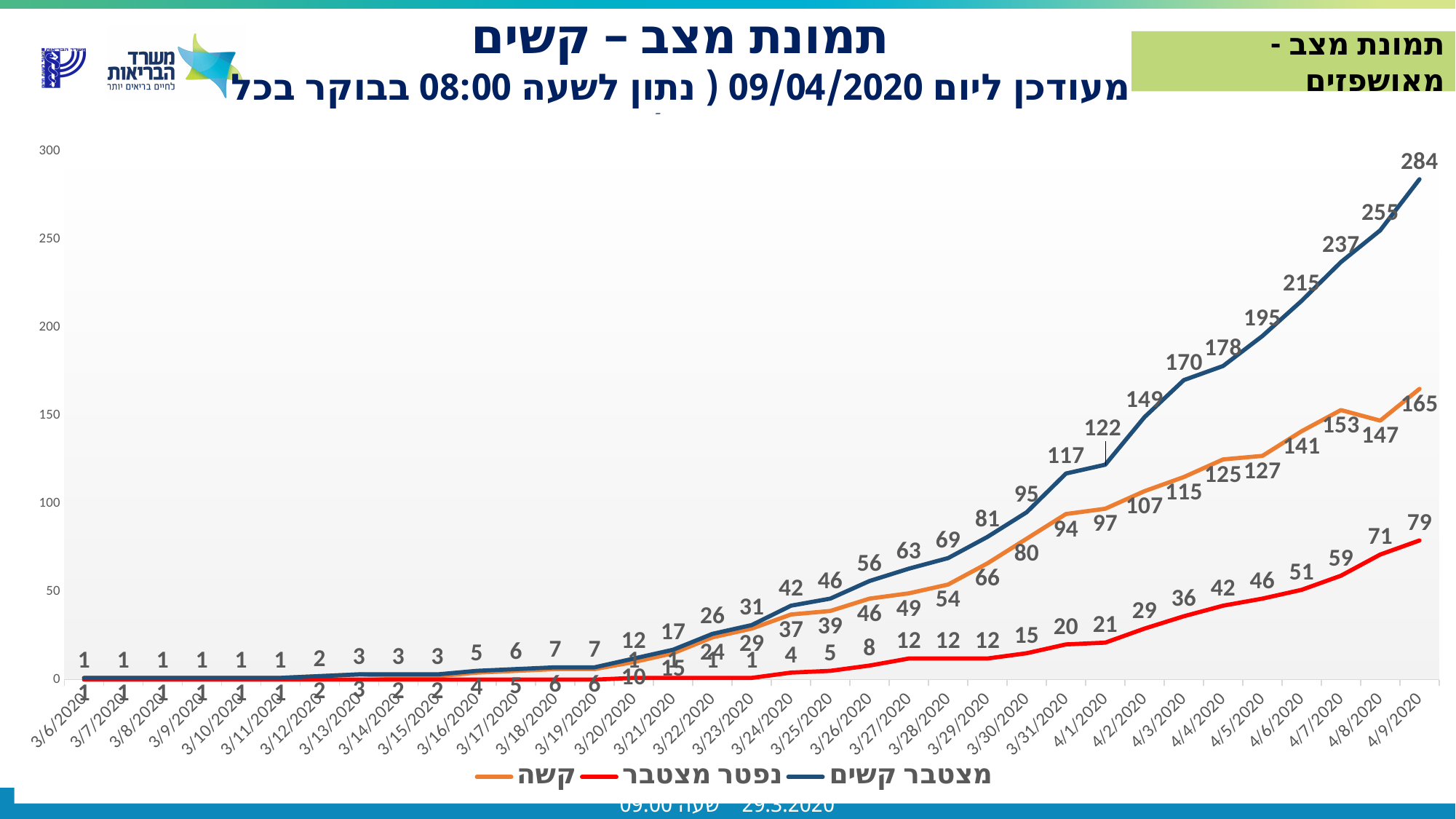
What is the value of מצטבר קשים on 3/31/2020? 117 By how much did נפטר מצטבר increase from 4/8/2020 to 4/9/2020? 8 By how much did מצטבר קשים increase from 4/8/2020 to 4/9/2020? 29 Does the מצטבר קשים series rise or fall from 3/6/2020 to 4/9/2020? rise On 4/9/2020, which is larger: מצטבר קשים or קשה? מצטבר קשים What is the value of קשה on 4/7/2020? 153 How many series does the legend list? 3 What kind of chart is shown on the slide? line chart On which date is מצטבר קשים highest? 4/9/2020 What is the value of מצטבר קשים on 4/9/2020? 284 What is the value of נפטר מצטבר on 4/9/2020? 79 What is the value of קשה on 4/9/2020? 165